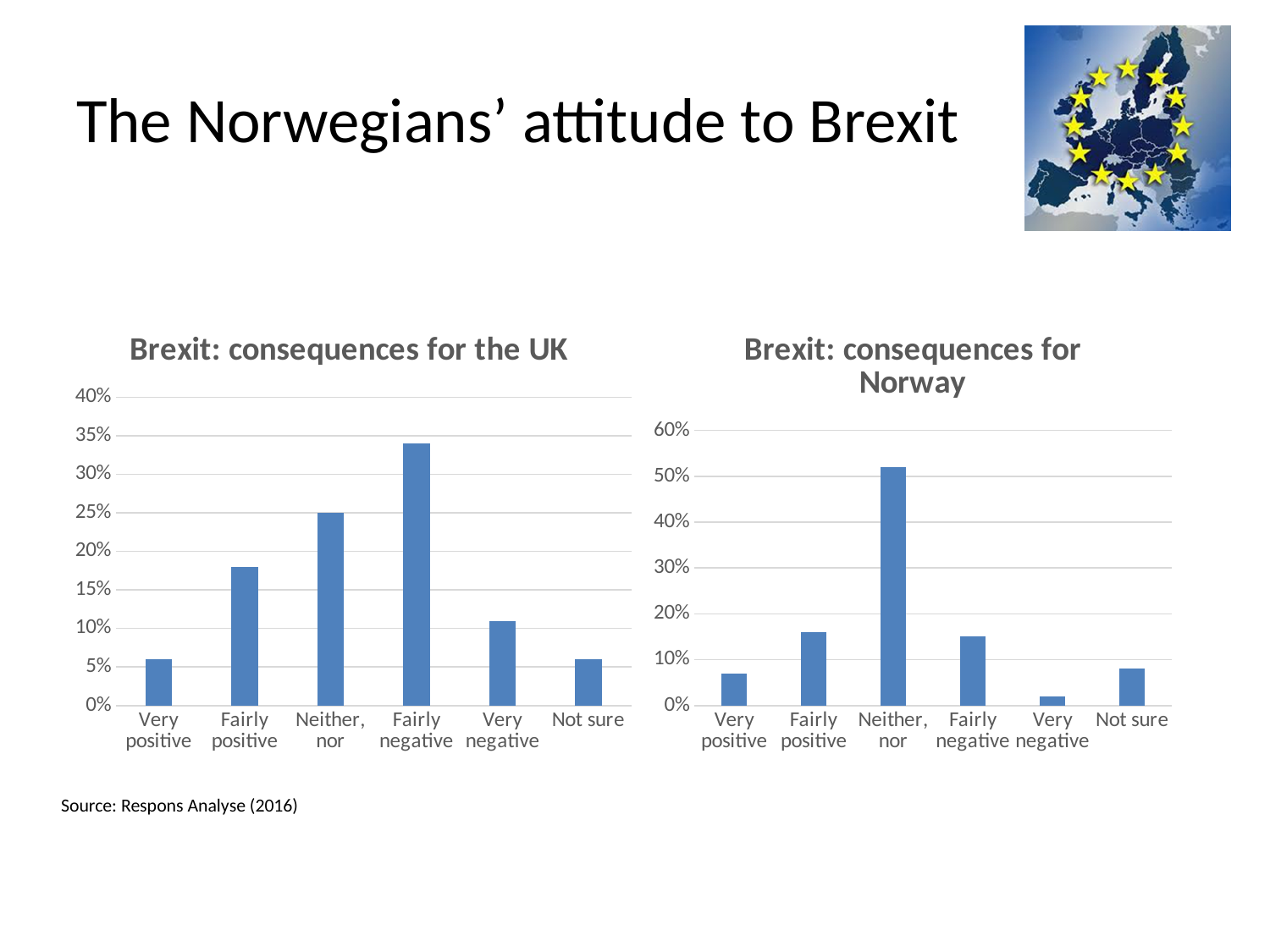
In the 'Brexit: consequences for the UK' chart, which category has the highest value? Fairly negative In the 'Brexit: consequences for Norway' chart, which is larger, Fairly positive or Not sure? Fairly positive In the 'Brexit: consequences for Norway' chart, which category has the lowest value? Very negative How many categories are shown in the 'Brexit: consequences for the UK' chart? 6 In the 'Brexit: consequences for Norway' chart, which category has the highest value? Neither, nor In the 'Brexit: consequences for the UK' chart, which is larger, Fairly positive or Very negative? Fairly positive In the 'Brexit: consequences for Norway' chart, is the value for Neither, nor greater or less than 50%? greater What is the title of the chart on the left side of the slide? Brexit: consequences for the UK What type of chart is the 'Brexit: consequences for Norway' chart? Bar chart In the 'Brexit: consequences for the UK' chart, is the value for Fairly negative greater or less than 30%? greater In the 'Brexit: consequences for Norway' chart, is the value for Very negative greater or less than 10%? less